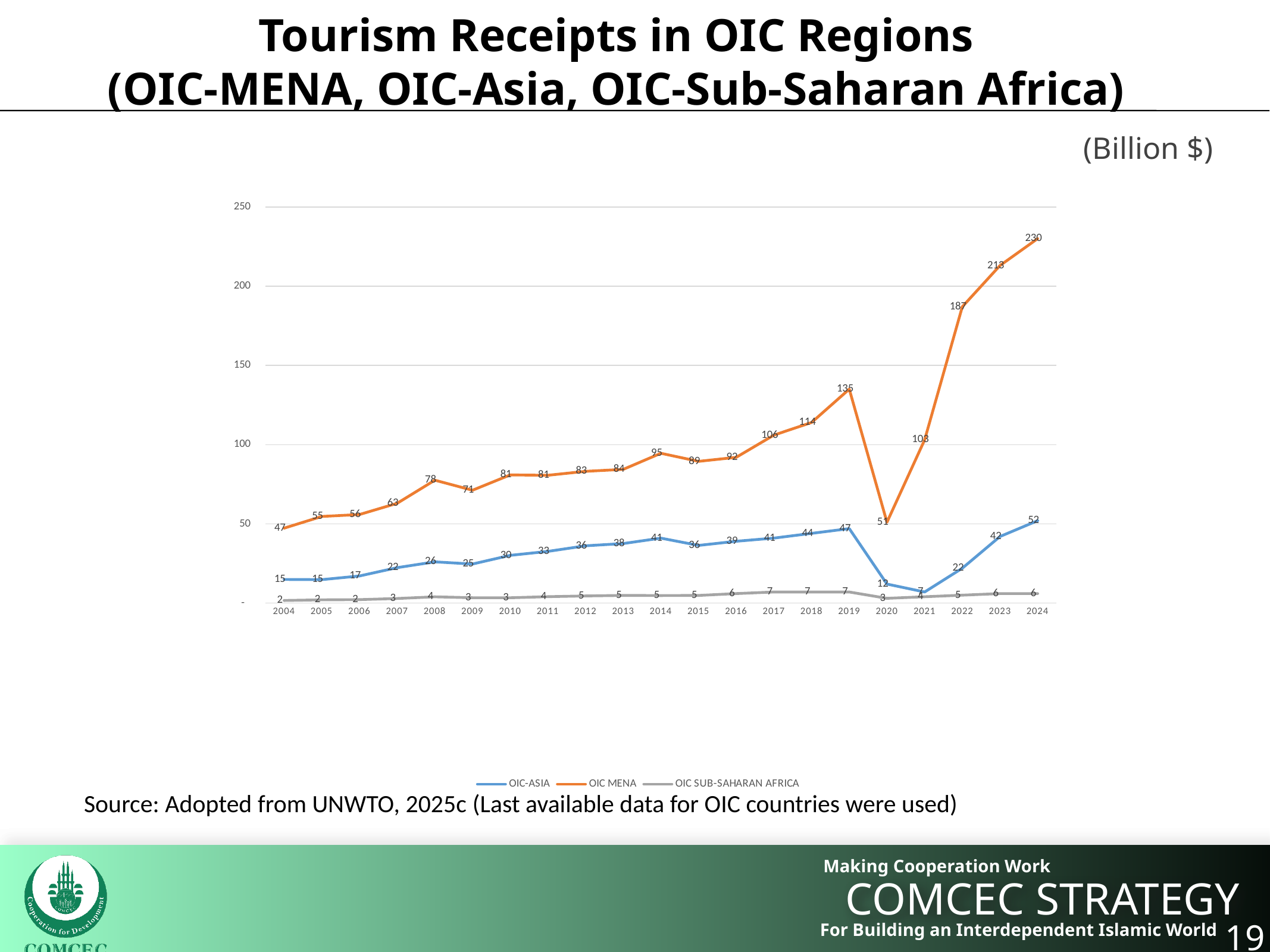
What is the difference between the OIC MENA values in 2024 and 2023? 17 What was the tourism receipts value for OIC MENA in 2024? 230 How many series does the legend list? 3 In which year did OIC-ASIA have its lowest value? 2021 What was the tourism receipts value for OIC SUB-SAHARAN AFRICA in 2017? 7 In which year did OIC MENA reach its highest value? 2024 What type of chart is shown on the slide? line chart What was the tourism receipts value for OIC MENA in 2020? 51 Which was larger in 2022: OIC MENA or OIC-ASIA? OIC MENA What unit is indicated for the values on the chart? Billion $ How many years are shown on the x axis? 21 What was the tourism receipts value for OIC-ASIA in 2019? 47